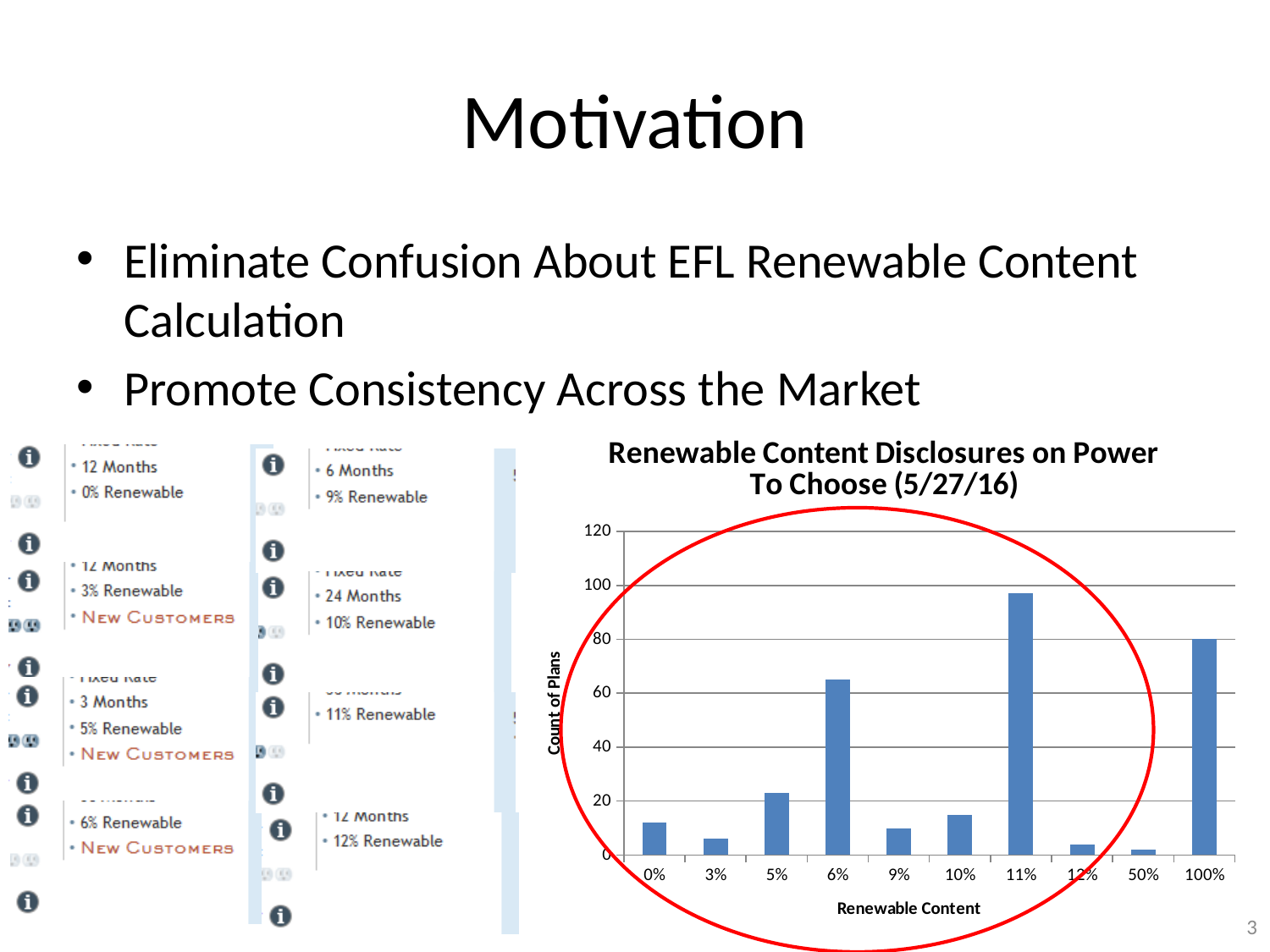
What is the title of the chart? Renewable Content Disclosures on Power To Choose (5/27/16) What is the label of the vertical axis of the chart? Count of Plans Is the count of plans for 5% renewable content greater or less than 40? less Which renewable content category has the highest count of plans? 11% What kind of chart is shown on the slide? bar chart Is the count of plans for 6% renewable content greater or less than 60? greater Is the count of plans for 0% renewable content greater or less than 20? less Which renewable content category has the lowest count of plans? 50% Which has a higher count of plans: 3% renewable content or 5% renewable content? 5% Which has a higher count of plans: 6% renewable content or 100% renewable content? 100% How many renewable content categories are shown on the x axis of the chart? 10